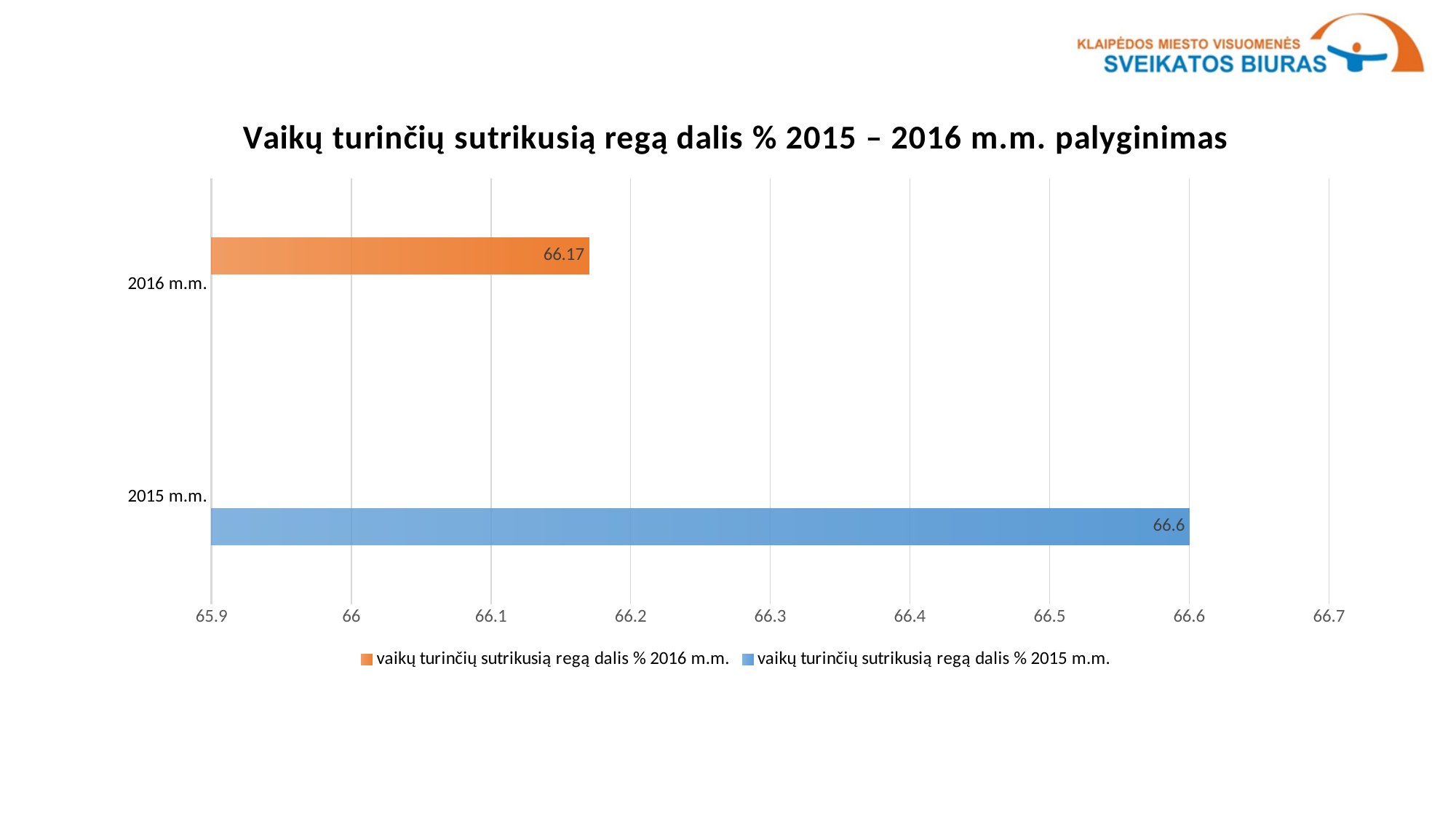
Is the value for 2016 m.m. larger or smaller than the value for 2015 m.m.? smaller What is the difference between the 2015 m.m. value and the 2016 m.m. value? 0.43 What kind of chart is shown on the slide? bar chart Is the value for 2016 m.m. greater or less than 66.2? less What is the value for 2016 m.m.? 66.17 How many series does the legend list? 2 Which category has the lower value? 2016 m.m. Which category has the higher value, 2015 m.m. or 2016 m.m.? 2015 m.m. What is the title of the chart? Vaikų turinčių sutrikusią regą dalis % 2015 – 2016 m.m. palyginimas What is the value for 2015 m.m.? 66.6 Is the value for 2015 m.m. greater or less than 66.5? greater How many categories are shown on the chart? 2